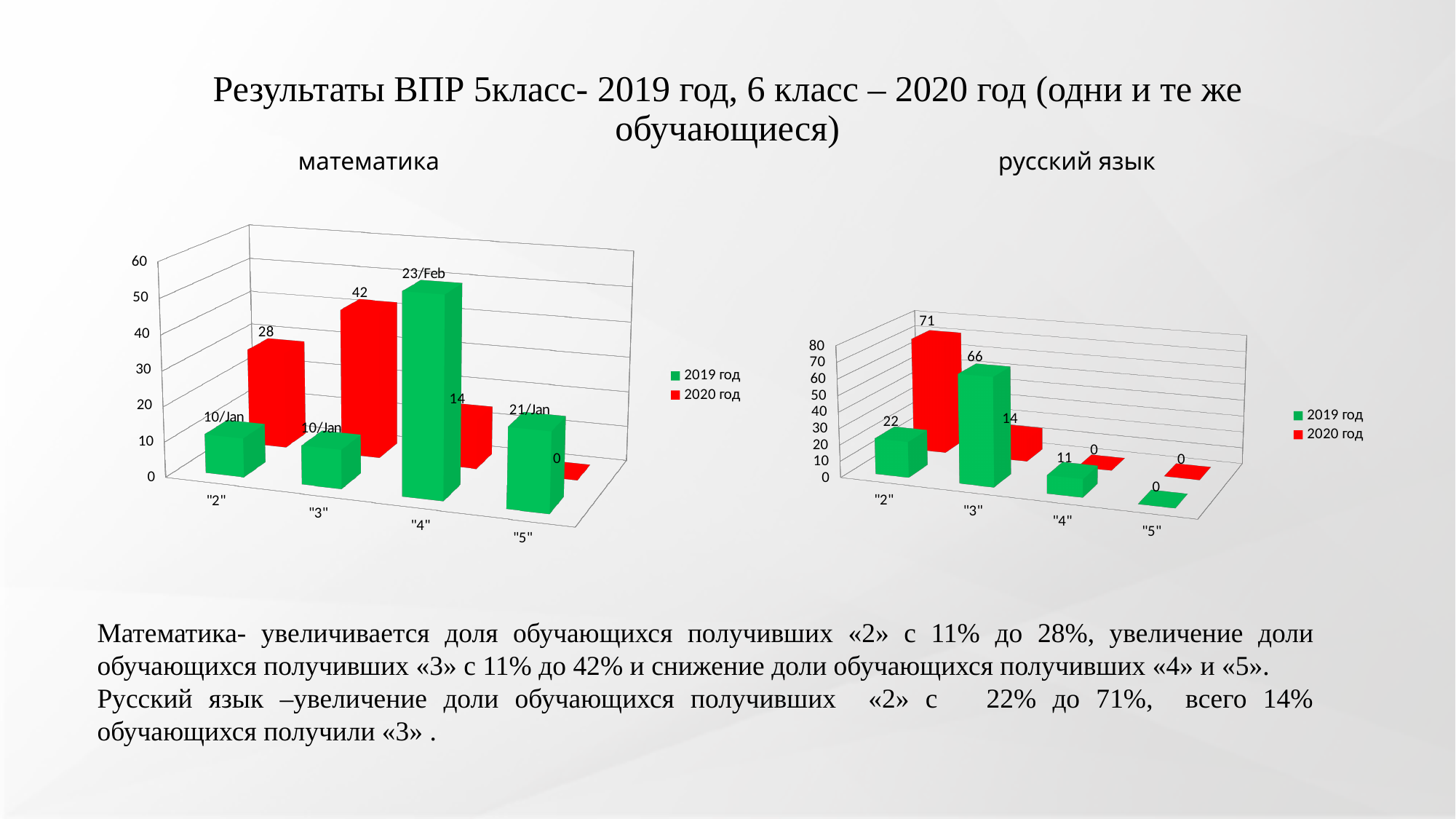
In the математика chart, what is the value for "3" in 2020 год? 42 In the математика chart, what is the value for "5" in 2020 год? 0 How many categories are shown on the x axis of the математика chart? 4 In the русский язык chart, what is the value for "2" in 2020 год? 71 In the русский язык chart, what is the difference between the 2019 год and 2020 год values for "3"? 52 In the математика chart, what is the value for "2" in 2020 год? 28 In the математика chart, which is larger for 2020 год: the value for "3" or the value for "4"? "3" In the русский язык chart, which category has the highest value for 2020 год? "2" In the русский язык chart, by how much did the value for "2" increase from 2019 год to 2020 год? 49 How many series does the legend of the математика chart list? 2 In the русский язык chart, what is the value for "3" in 2019 год? 66 What kind of chart is the русский язык chart? bar chart